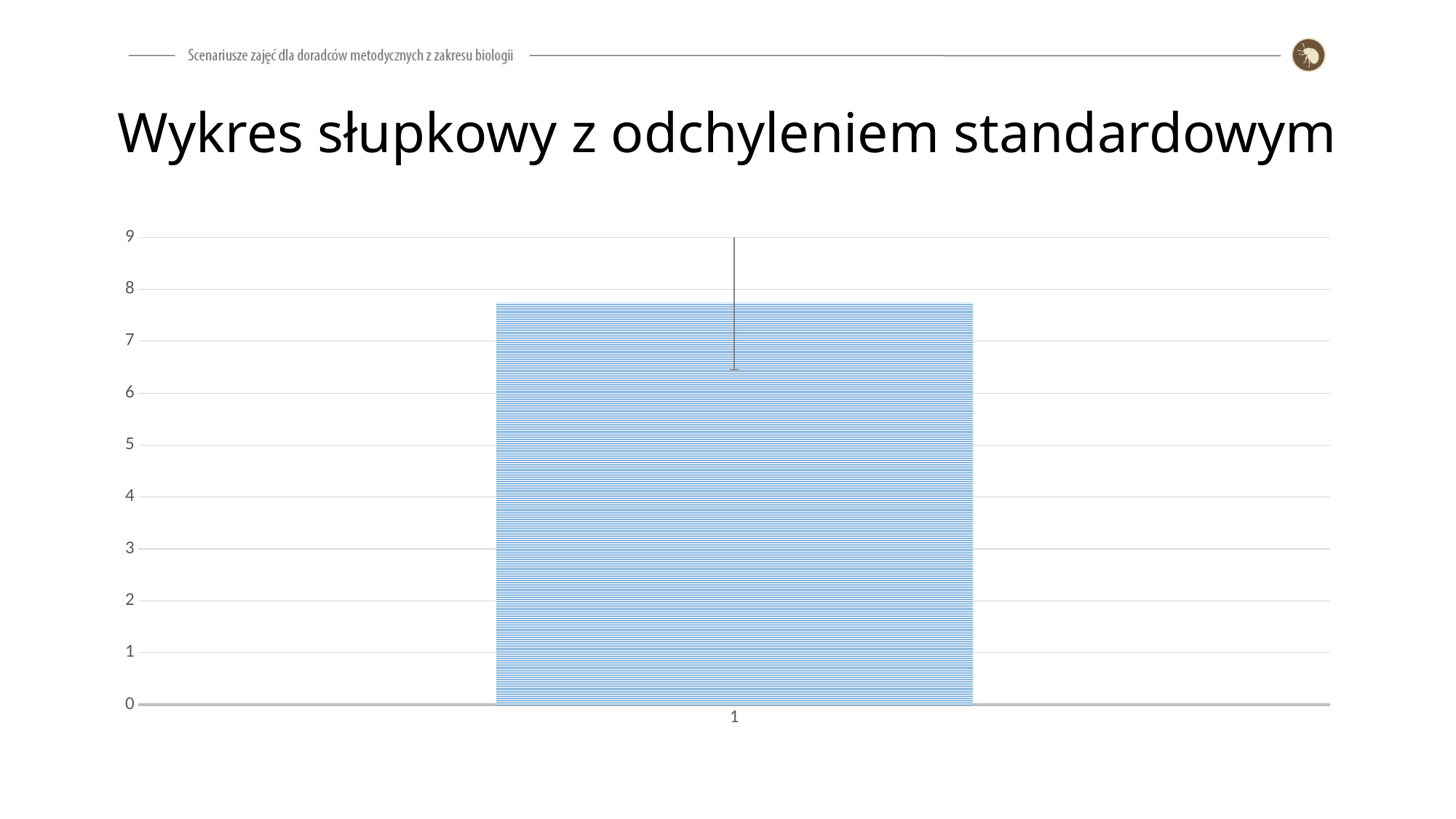
Is the value of the bar for category 1 greater or less than 8? less What is the title of the slide above the chart? Wykres słupkowy z odchyleniem standardowym What kind of chart is shown on the slide? bar chart What is the highest value shown on the vertical axis of the chart? 9 Is the value of the bar for category 1 greater or less than 7? greater Is the value of the bar for category 1 greater or less than 5? greater How many bars are plotted in the chart? 1